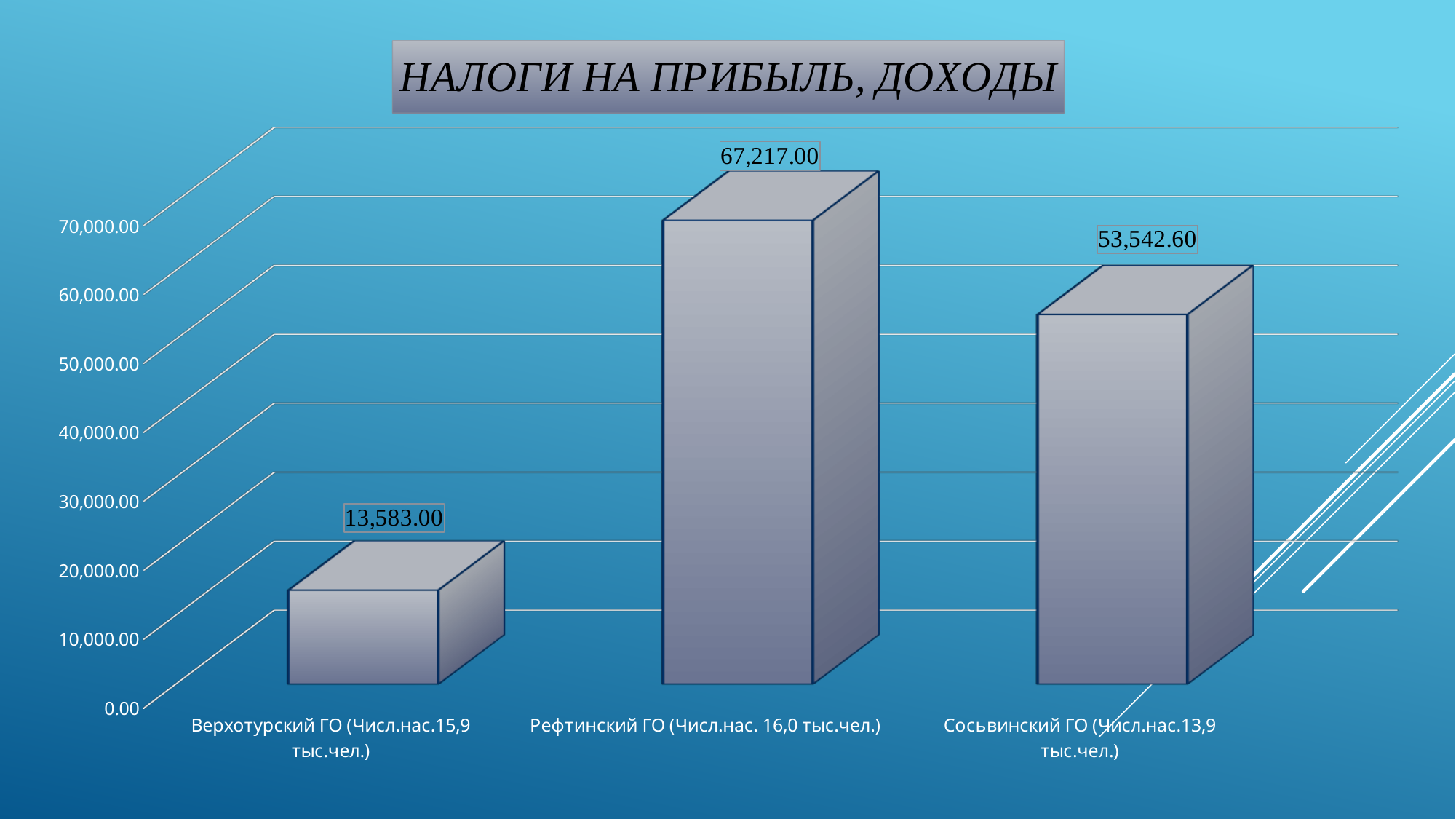
Which category has the highest value? Рефтинский ГО Is the value for Сосьвинский ГО greater or less than 50,000.00? greater Which is larger, the value for Сосьвинский ГО or the value for Верхотурский ГО? Сосьвинский ГО What kind of chart is shown on the slide? Bar chart What is the difference between the values for Сосьвинский ГО and Верхотурский ГО? 39,959.60 What is the value for Верхотурский ГО? 13,583.00 What is the difference between the values for Рефтинский ГО and Сосьвинский ГО? 13,674.40 What is the value for Рефтинский ГО? 67,217.00 What is the title of the chart? НАЛОГИ НА ПРИБЫЛЬ, ДОХОДЫ Which category has the lowest value? Верхотурский ГО What is the value for Сосьвинский ГО? 53,542.60 How many categories are shown in the chart? 3